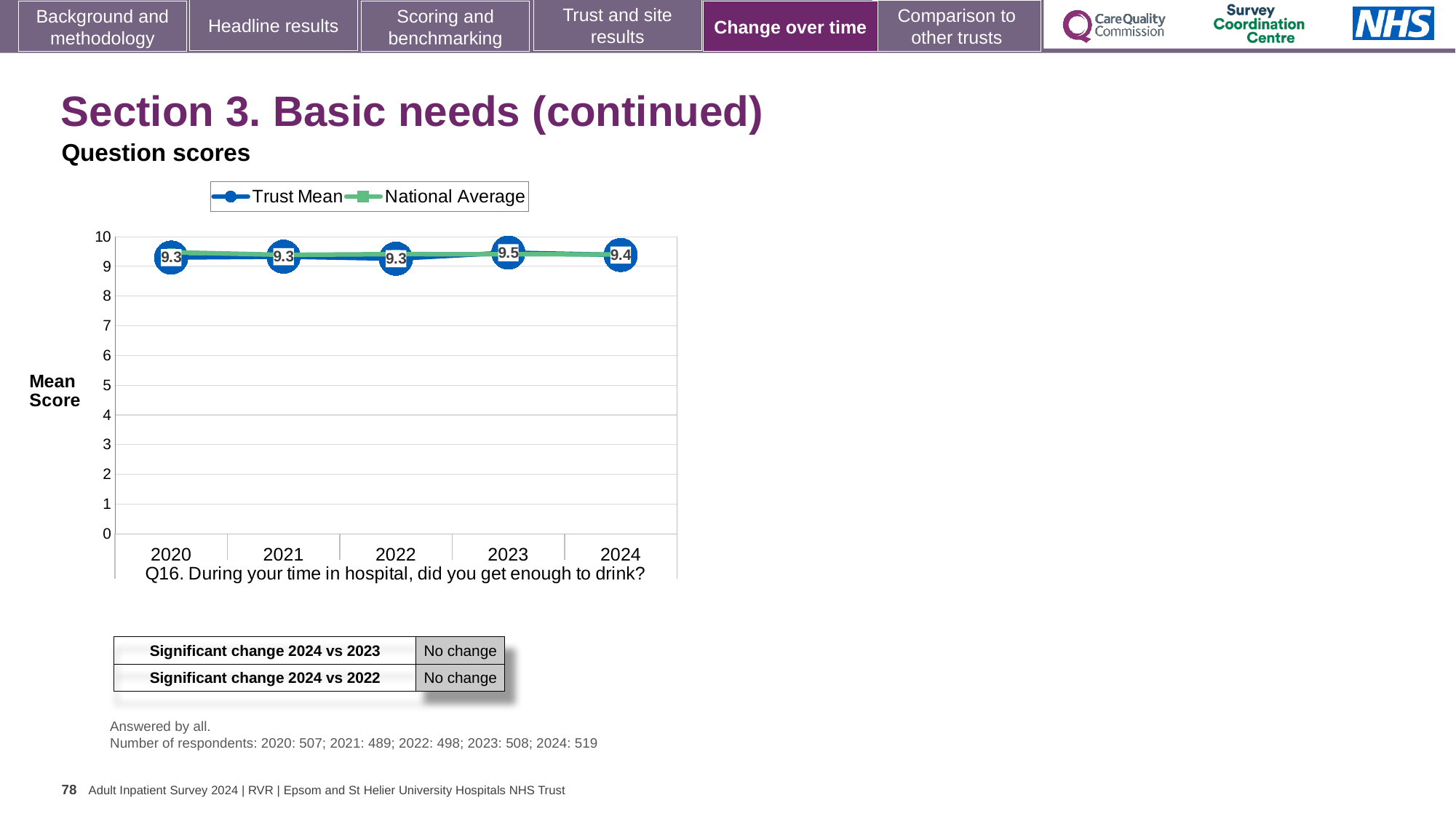
How many years are plotted on the x axis? 5 What is the difference between the Trust Mean scores for 2023 and 2022? 0.2 In which year is the Trust Mean score highest? 2023 How many series does the legend list? 2 What is the Trust Mean score for 2024? 9.4 Does the Trust Mean score rise or fall from 2022 to 2023? rise What kind of chart is shown? line chart What is the Trust Mean score for 2020? 9.3 What is the Trust Mean score for 2023? 9.5 Which year has the larger Trust Mean score, 2023 or 2024? 2023 Is the National Average value for 2024 greater or less than 9? greater Which question does the chart show scores for? Q16. During your time in hospital, did you get enough to drink?